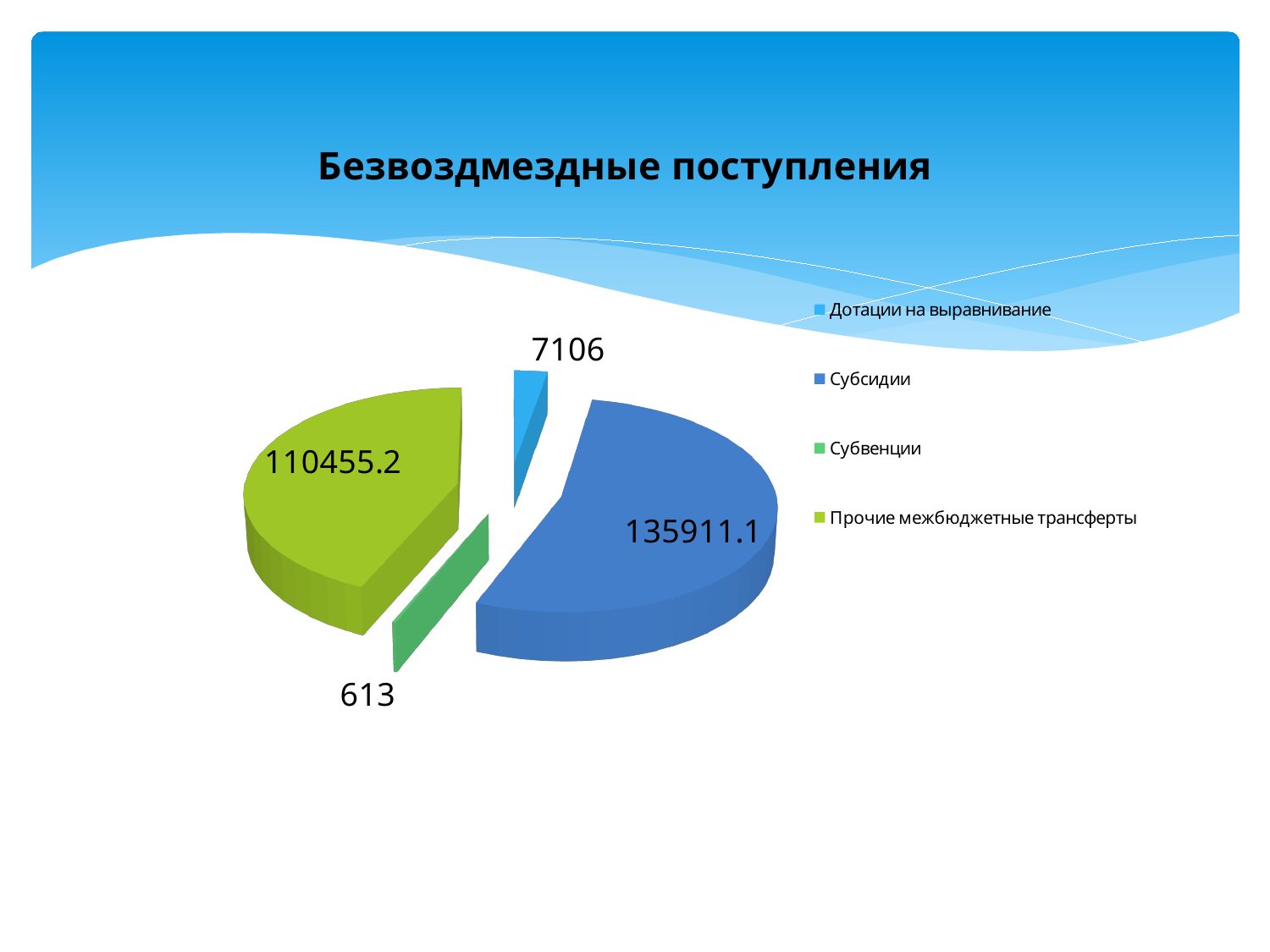
Which category has the largest slice of the pie? Субсидии Which is larger, the value for Дотации на выравнивание or the value for Субвенции? Дотации на выравнивание What is the value for Прочие межбюджетные трансферты? 110455.2 What is the value for Субсидии? 135911.1 What is the value for Субвенции? 613 What type of chart is shown on the slide? pie chart What is the value for Дотации на выравнивание? 7106 What is the difference between the values for Субсидии and Прочие межбюджетные трансферты? 25455.9 What is the title of the chart? Безвоздмездные поступления What is the difference between the values for Дотации на выравнивание and Субвенции? 6493 How many categories does the legend list? 4 Which category has the smallest slice of the pie? Субвенции